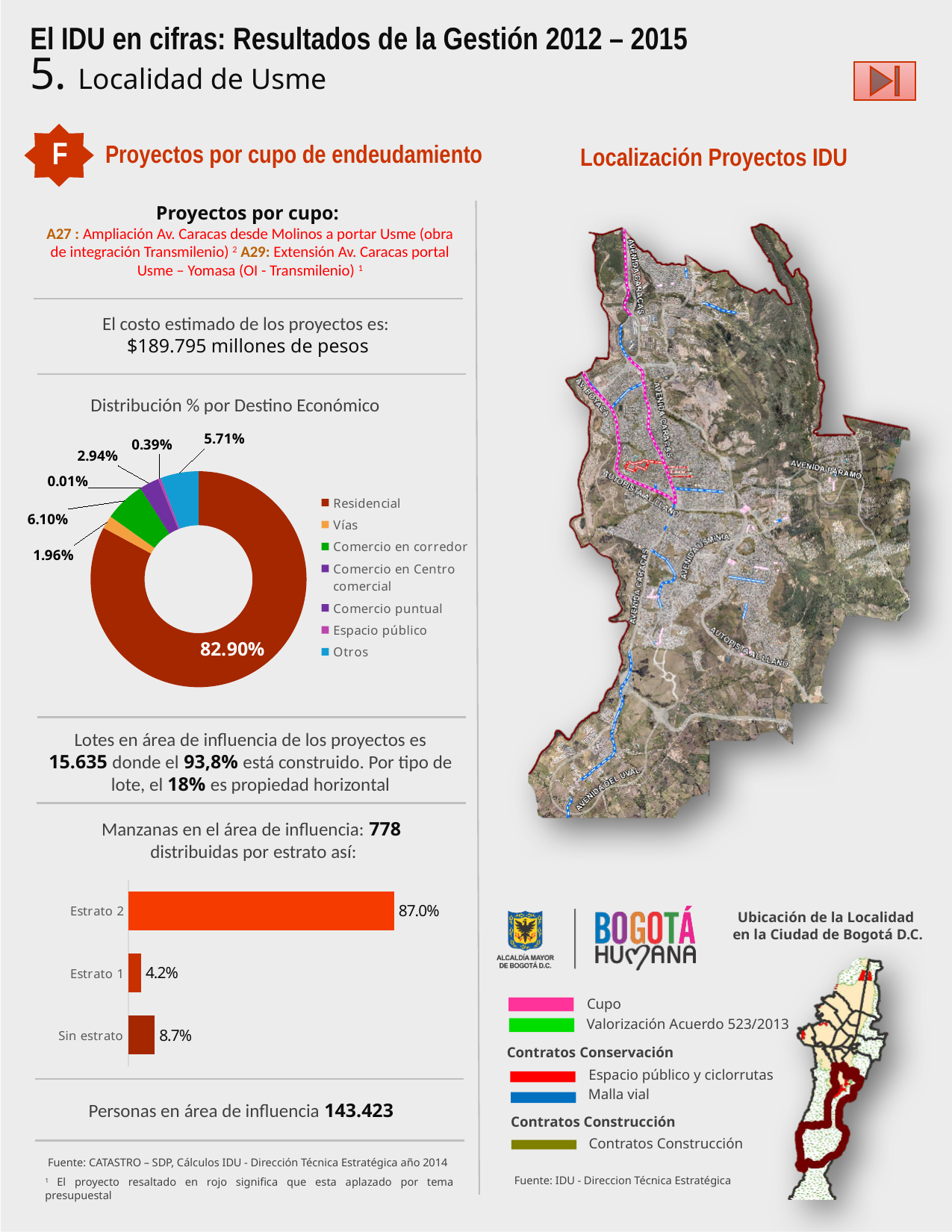
In the 'Distribución % por Destino Económico' chart, what is the share shown for Otros (the blue slice)? 5.71% In the 'Distribución % por Destino Económico' chart, what percentage is shown for Residencial? 82.90% In the 'Distribución % por Destino Económico' chart, which category has the largest share? Residencial What kind of chart is 'Distribución % por Destino Económico'? Donut (pie) chart In the 'Manzanas en el área de influencia' bar chart, what is the value for Sin estrato? 8.7% In the 'Manzanas en el área de influencia' bar chart, what is the value for Estrato 2? 87.0% In the 'Distribución % por Destino Económico' chart, what is the share shown for Comercio en corredor (the green slice)? 6.10% In the 'Manzanas en el área de influencia' bar chart, which category has the lowest value? Estrato 1 In the 'Distribución % por Destino Económico' chart, what is the smallest percentage label shown? 0.01% How many categories are shown in the 'Manzanas en el área de influencia' bar chart? 3 In the 'Manzanas en el área de influencia' bar chart, what is the difference between Estrato 2 and Sin estrato? 78.3% How many entries does the legend of the 'Distribución % por Destino Económico' chart list? 7